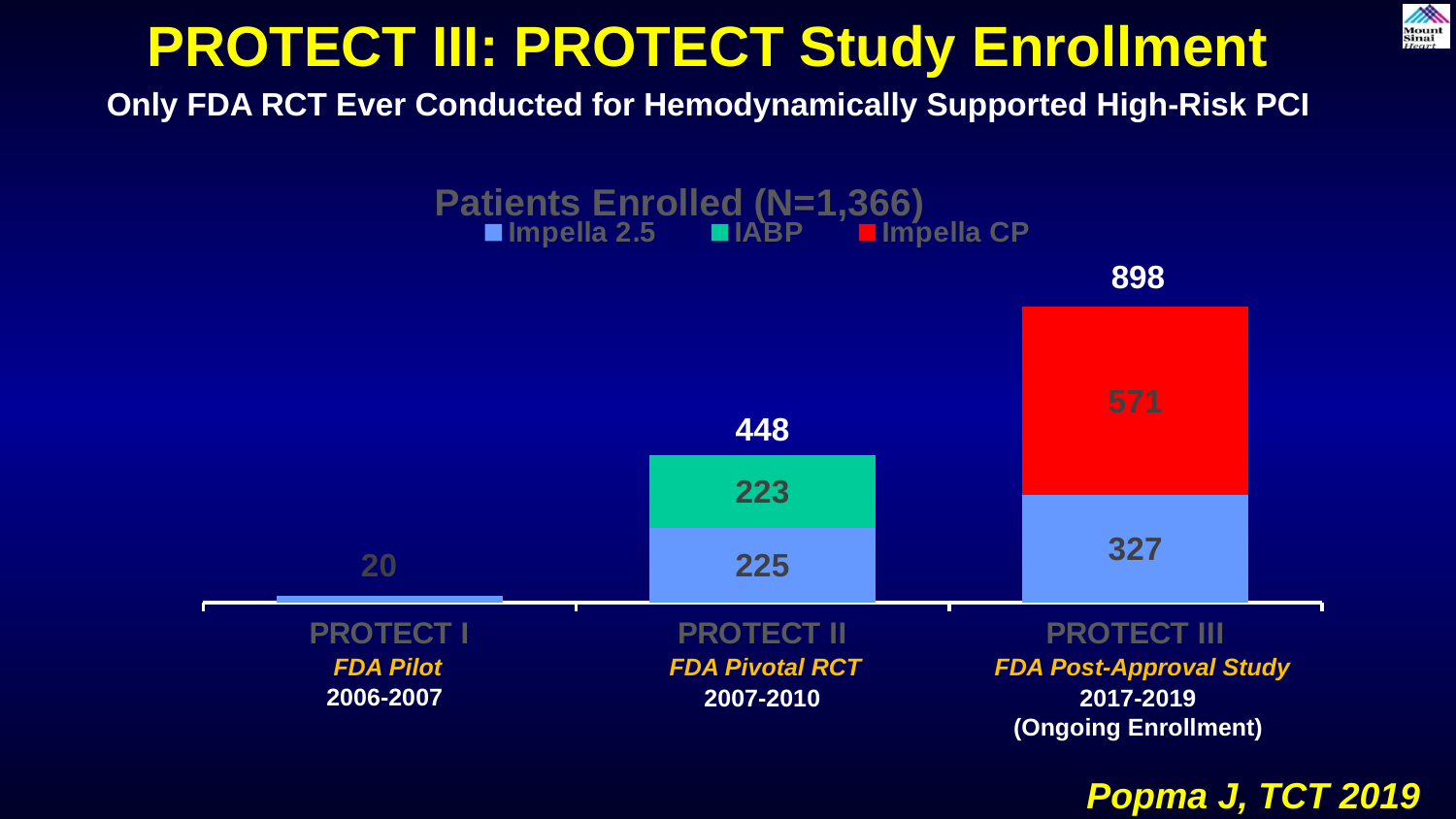
Which is larger in PROTECT III: the Impella CP count or the Impella 2.5 count? Impella CP How many series does the legend list? 3 Which study has the lowest total enrollment? PROTECT I How many Impella CP patients were enrolled in PROTECT III? 571 What type of chart is shown? Stacked bar chart What is the title of the chart? Patients Enrolled (N=1,366) What is the total number of patients enrolled in PROTECT III? 898 How many Impella 2.5 patients were enrolled in PROTECT II? 225 What is the difference in total enrollment between PROTECT III and PROTECT II? 450 Which study has the highest total enrollment? PROTECT III How many patients were enrolled in PROTECT I? 20 How many IABP patients were enrolled in PROTECT II? 223